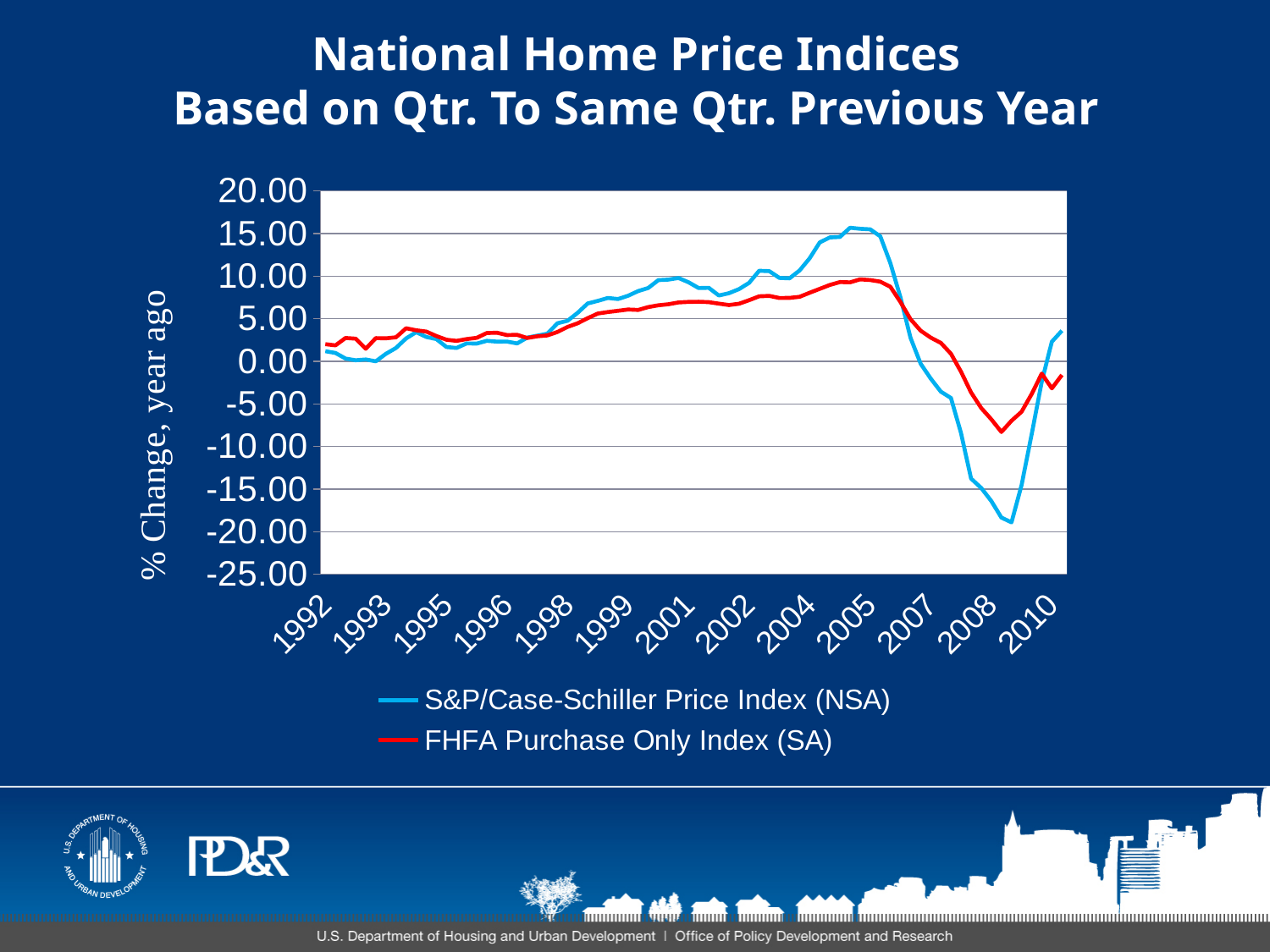
Which series is drawn in red? FHFA Purchase Only Index (SA) How many year labels are shown along the x axis? 13 At the 2005 peak, which series has the higher value: S&P/Case-Schiller Price Index (NSA) or FHFA Purchase Only Index (SA)? S&P/Case-Schiller Price Index (NSA) Between 2007 and 2008, do the values of both series rise or fall? fall What kind of chart is shown on the slide? Line chart Around 2008, which series falls to the lower value: S&P/Case-Schiller Price Index (NSA) or FHFA Purchase Only Index (SA)? S&P/Case-Schiller Price Index (NSA) Is the lowest value of the S&P/Case-Schiller Price Index (NSA) around 2008 greater or less than -15.00? less Is the peak value of the FHFA Purchase Only Index (SA) around 2005 greater or less than 5.00? greater What is the label on the vertical axis? % Change, year ago How many series does the legend list? 2 Is the peak value of the S&P/Case-Schiller Price Index (NSA) around 2005 greater or less than 10.00? greater